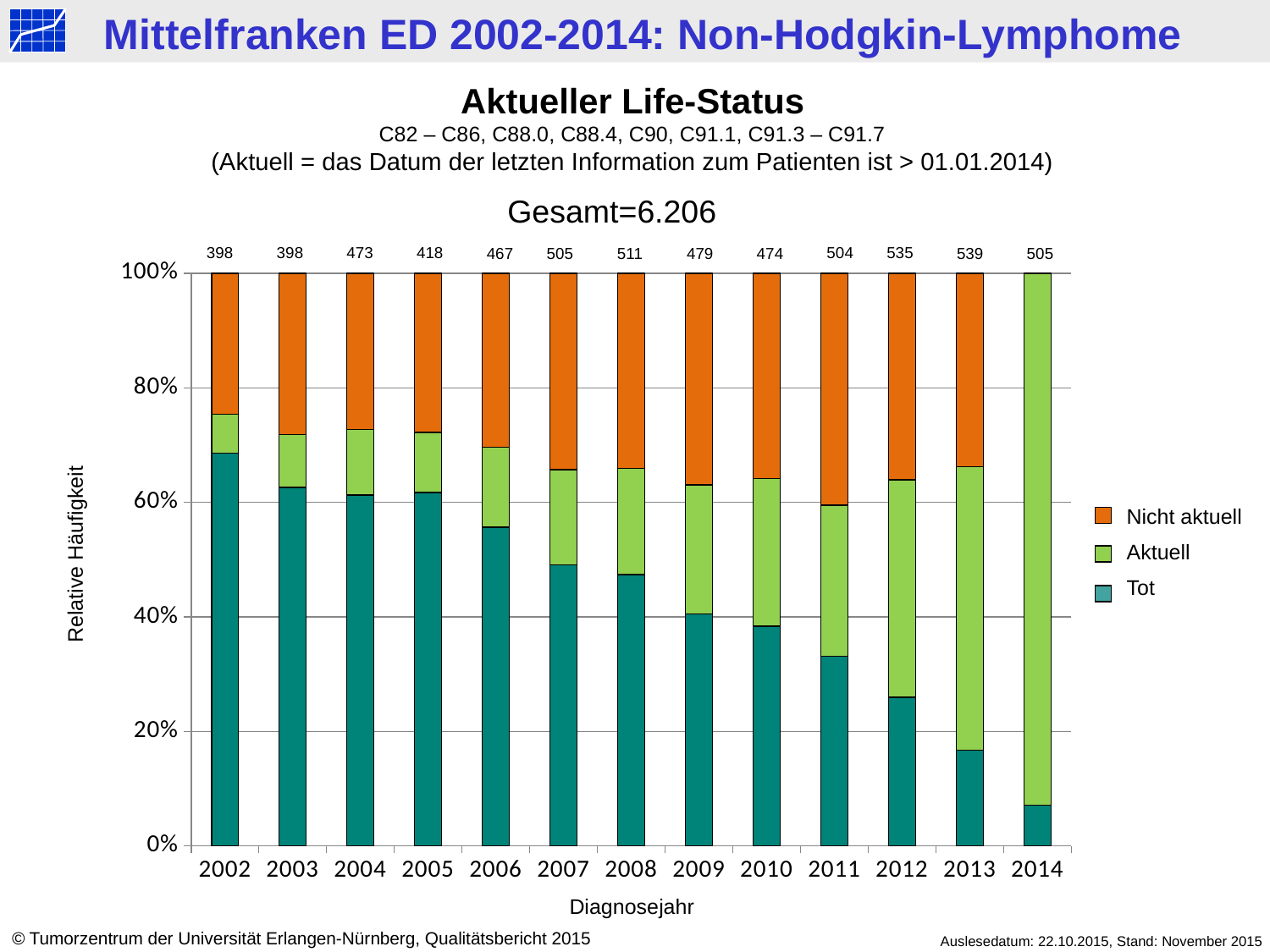
Does the share of 'Tot' rise or fall from 2002 to 2014? fall What kind of chart is shown on the slide? Stacked bar chart Is the share of 'Tot' in 2014 greater or less than 20%? less How many diagnosis years are shown on the x axis? 13 What number is printed above the bar for 2013? 539 What is the difference between the numbers printed above the bars for 2013 and 2002? 141 What number is printed above the bar for 2002? 398 Is the share of 'Tot' in 2002 greater or less than 60%? greater How many series does the legend list? 3 Which year has the larger number printed above its bar, 2008 or 2009? 2008 Which diagnosis year has the highest number printed above its bar? 2013 What number is printed above the bar for 2008? 511